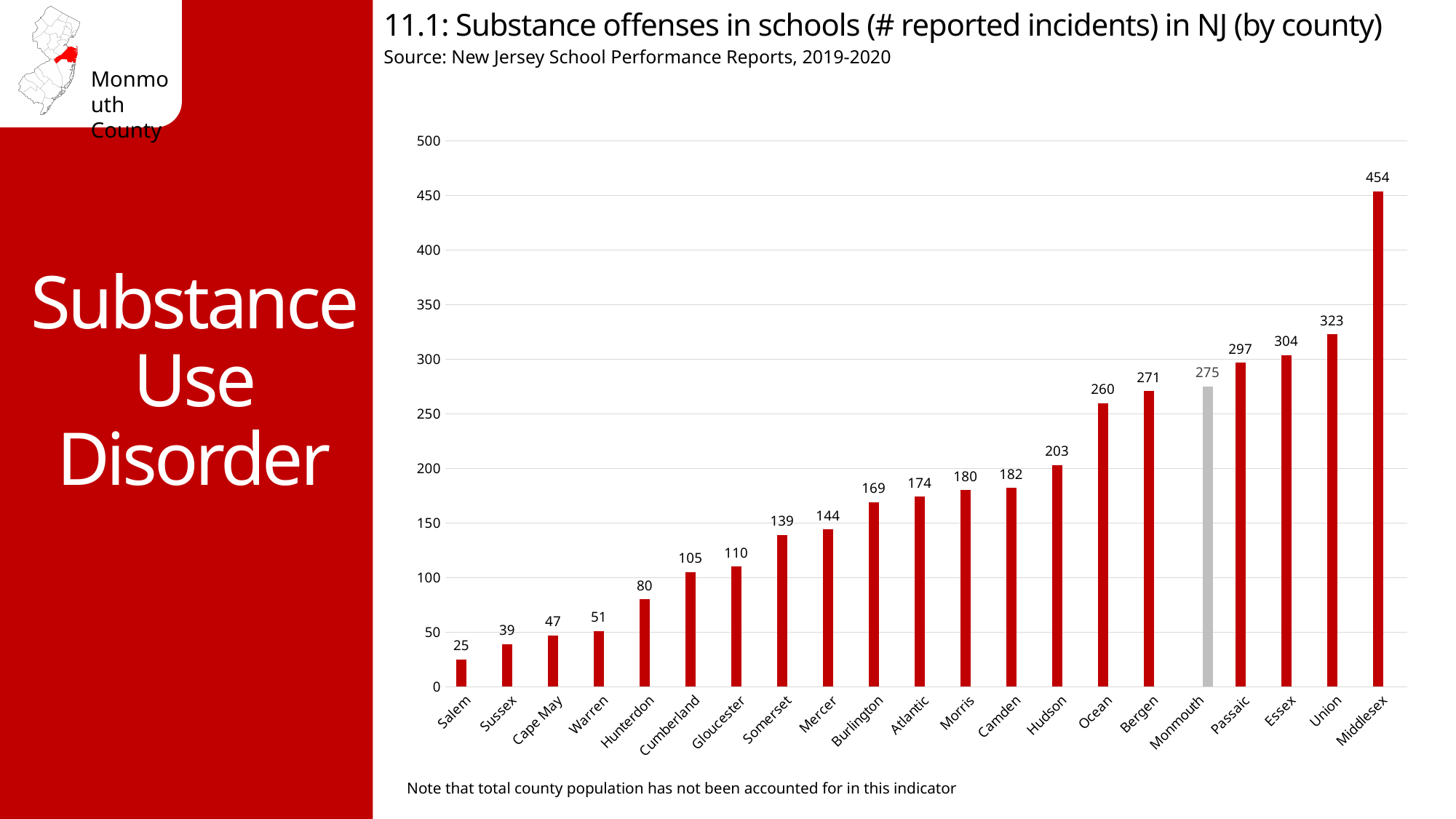
Do the values rise or fall moving from left to right along the x axis? Rise Which county has the lowest number of reported incidents? Salem What is the difference between the values for Monmouth and Salem? 250 Which county's bar is coloured grey instead of red? Monmouth Which county has a larger value, Bergen or Passaic? Passaic Which county has the highest number of reported incidents? Middlesex What kind of chart is shown on the slide? Bar chart What is the value shown for Hudson County? 203 How many counties are shown on the chart? 21 What is the difference between the values for Middlesex and Union? 131 What is the number of reported substance offense incidents in schools for Monmouth County? 275 Is the value for Ocean County greater or less than 250? greater